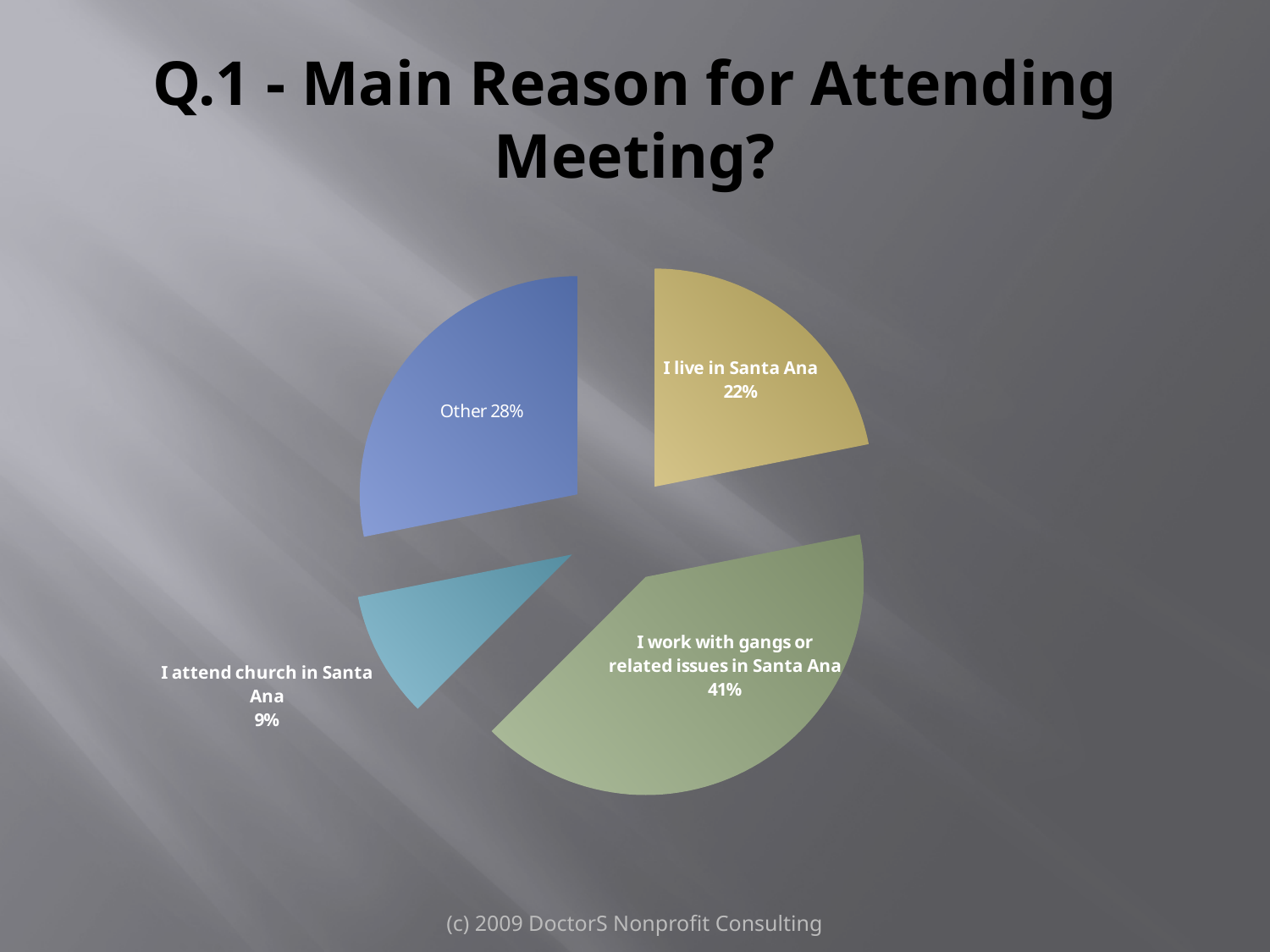
Which is larger: the share for 'Other' or the share for 'I live in Santa Ana'? Other What is the title of the chart on the slide? Q.1 - Main Reason for Attending Meeting? Which reason has the largest share of the pie? I work with gangs or related issues in Santa Ana What kind of chart is shown on the slide? pie chart What is the difference in percentage points between 'I work with gangs or related issues in Santa Ana' and 'I live in Santa Ana'? 19 What is the value shown for 'Other'? 28% How many slices does the pie chart have? 4 What share of respondents gave 'I work with gangs or related issues in Santa Ana' as their main reason for attending? 41% What percentage is shown for 'I attend church in Santa Ana'? 9% What is the difference in percentage points between 'Other' and 'I attend church in Santa Ana'? 19 Which reason has the smallest share of the pie? I attend church in Santa Ana What percentage of the pie is 'I live in Santa Ana'? 22%